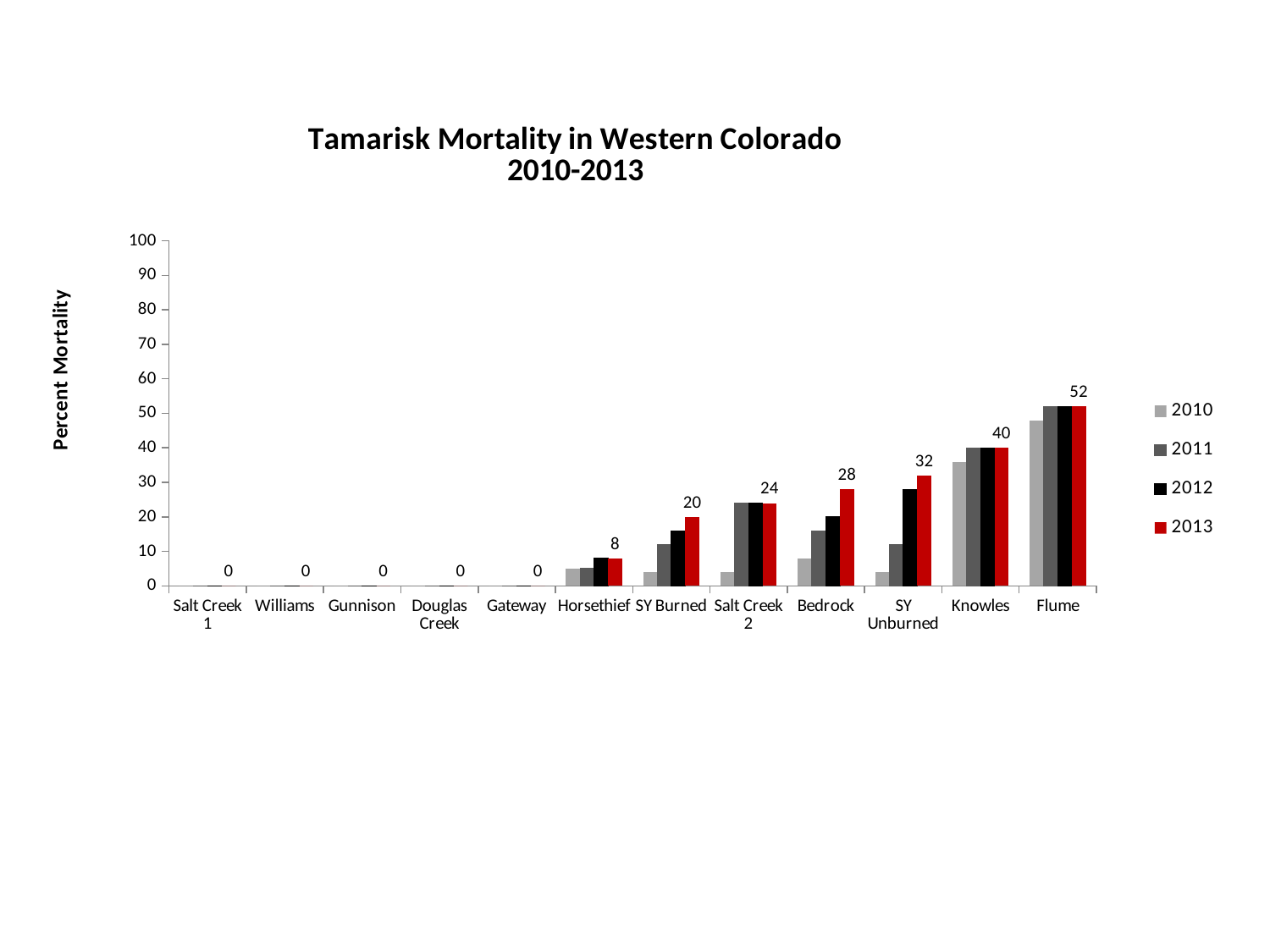
Is the 2012 value for Bedrock greater or less than 30? less Which is larger, the 2013 value for Salt Creek 2 or the 2013 value for SY Burned? Salt Creek 2 How many sites are shown on the x axis? 12 What is the 2013 value for Flume? 52 What is the 2013 value for Horsethief? 8 Is the 2010 value for Flume greater or less than 40? greater What is the 2013 value for Bedrock? 28 Which site has the highest 2013 mortality? Flume What kind of chart is this? bar chart How many series does the legend list? 4 What is the y-axis label of the chart? Percent Mortality What is the difference between the 2013 values for Knowles and SY Unburned? 8